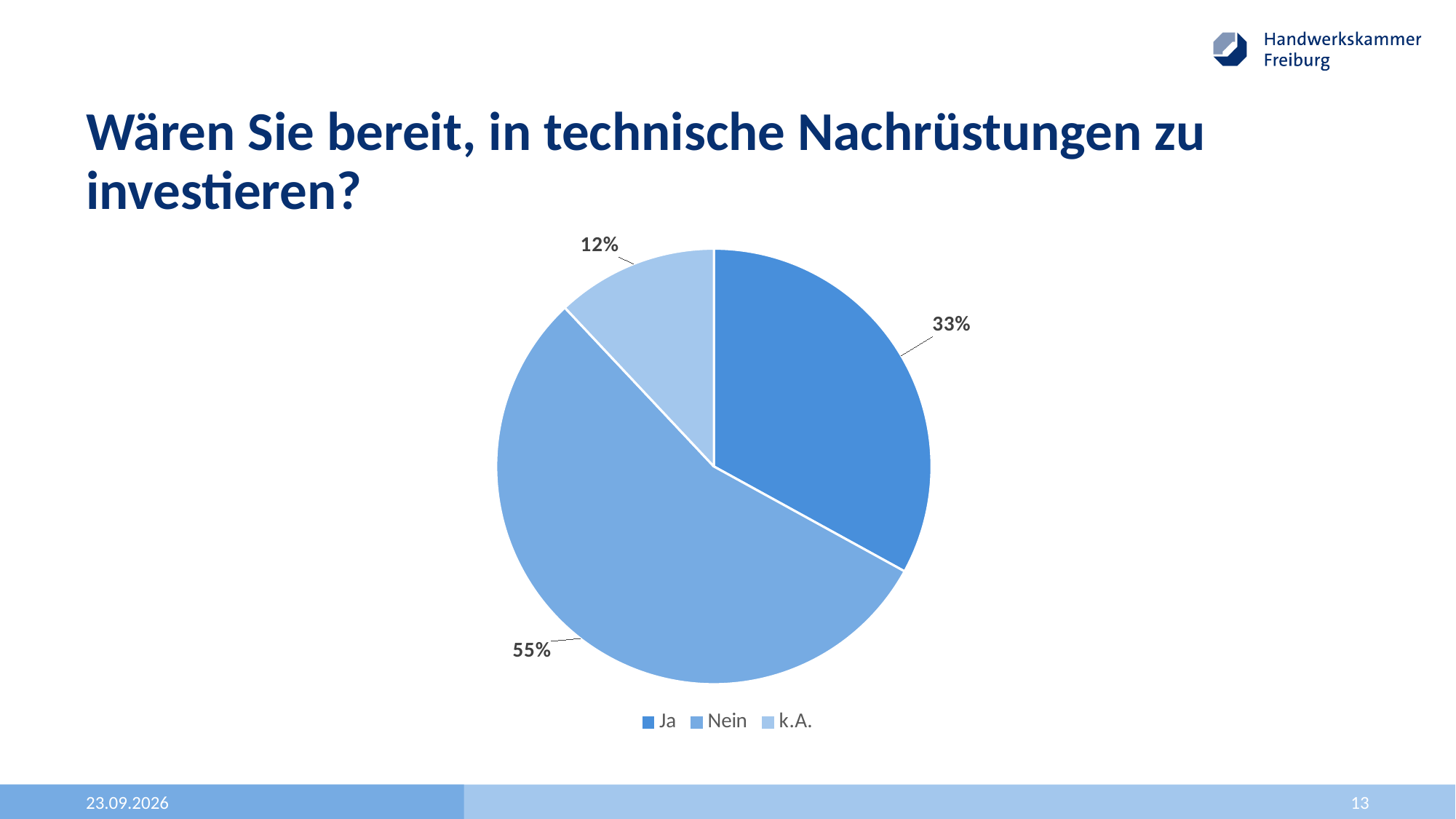
How many slices does the pie chart have? 3 What is the difference in percentage points between the "Ja" and "k.A." slices? 21 What share of the pie is labelled "k.A."? 12% Which slice is larger, "Ja" or "k.A."? Ja What share of the pie is labelled "Nein"? 55% What is the title of the slide containing the chart? Wären Sie bereit, in technische Nachrüstungen zu investieren? What is the difference in percentage points between the "Nein" and "Ja" slices? 22 What kind of chart is shown on the slide? Pie chart Which category has the largest slice of the pie? Nein What share of the pie is labelled "Ja"? 33% Which category has the smallest slice of the pie? k.A. How many entries does the legend list? 3